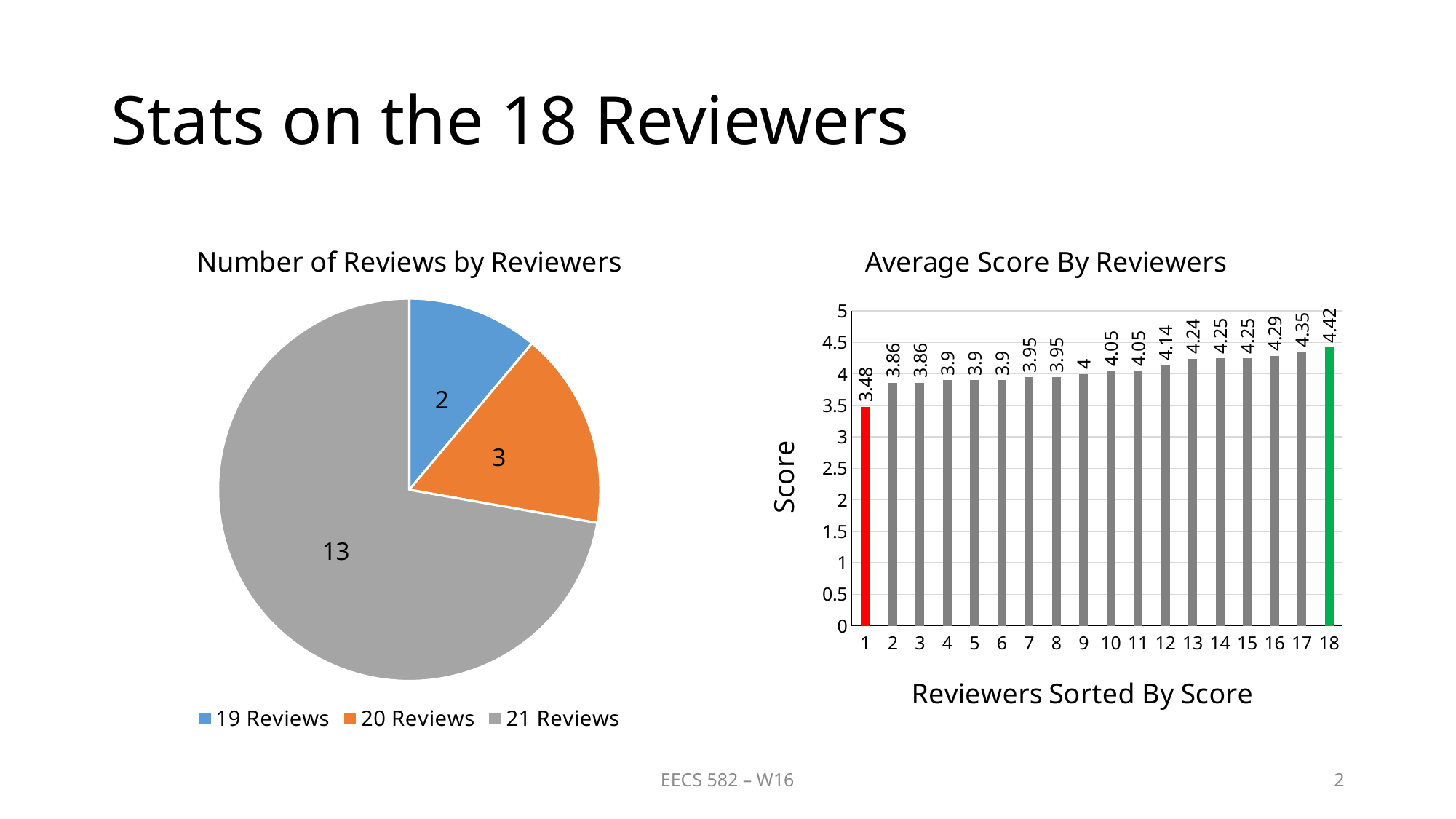
In the 'Average Score By Reviewers' chart, what colour is the bar for reviewer 18? green In the 'Number of Reviews by Reviewers' chart, which category has the largest slice? 21 Reviews In the 'Average Score By Reviewers' chart, what is the difference between the scores of reviewer 18 and reviewer 1? 0.94 In the 'Number of Reviews by Reviewers' chart, how many reviewers wrote 21 reviews? 13 What kind of chart is 'Number of Reviews by Reviewers'? pie chart In the 'Number of Reviews by Reviewers' chart, how many reviewers wrote 19 reviews? 2 In the 'Average Score By Reviewers' chart, what is the score for reviewer 1? 3.48 In the 'Number of Reviews by Reviewers' chart, what is the total number of reviewers across all slices? 18 In the 'Number of Reviews by Reviewers' chart, how many categories does the legend list? 3 In the 'Average Score By Reviewers' chart, do the scores rise or fall from reviewer 1 to reviewer 18? rise In the 'Average Score By Reviewers' chart, how many reviewers are plotted? 18 In the 'Average Score By Reviewers' chart, what is the score for reviewer 18? 4.42